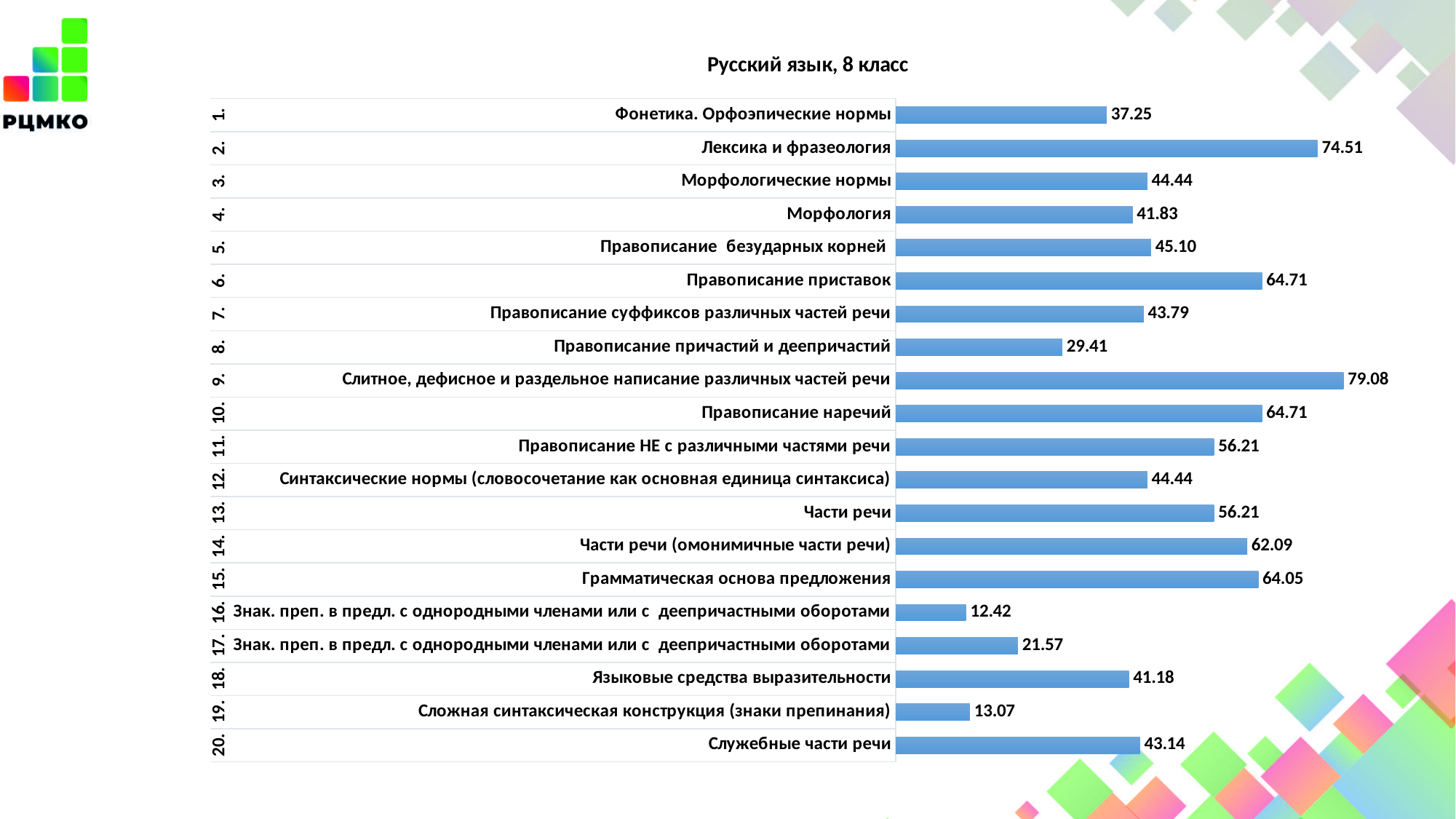
What is the difference between the values for Правописание приставок and Правописание причастий и деепричастий? 35.30 What is the value for Сложная синтаксическая конструкция (знаки препинания)? 13.07 How many categories are shown on the chart? 20 What is the difference between the values for Слитное, дефисное и раздельное написание различных частей речи and Лексика и фразеология? 4.57 What is the value for Грамматическая основа предложения? 64.05 Which is larger, the value for Части речи (омонимичные части речи) or the value for Правописание НЕ с различными частями речи? Части речи (омонимичные части речи) Which category has the highest value? Слитное, дефисное и раздельное написание различных частей речи What is the lowest value shown on the chart? 12.42 What is the title of the chart? Русский язык, 8 класс What kind of chart is shown on the slide? Bar chart What is the value for Правописание причастий и деепричастий? 29.41 What is the value for Лексика и фразеология? 74.51